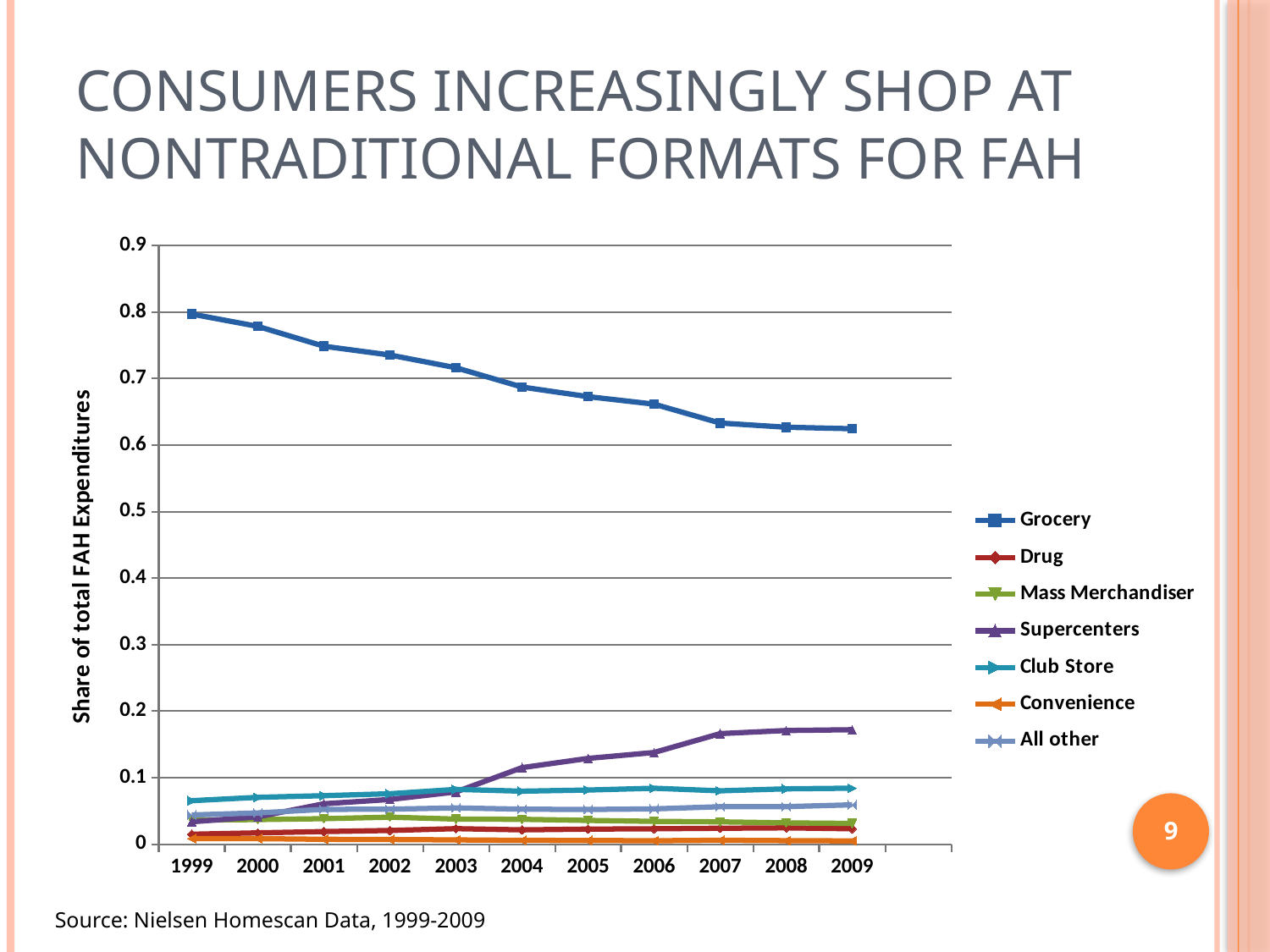
Which series has the highest share in 2009? Grocery Does the Grocery share rise or fall from 1999 to 2009? Fall Which series has the lowest share in 2009? Convenience What kind of chart is shown on the slide? Line chart How many years are plotted along the x axis? 11 Is the Supercenters value for 2009 greater or less than 0.2? less Is the Grocery value for 2009 greater or less than 0.7? less In 2009, which is larger: the Supercenters share or the Club Store share? Supercenters How many series does the legend list? 7 What is the label of the y axis? Share of total FAH Expenditures Does the Supercenters share rise or fall from 1999 to 2009? Rise Is the Grocery value for 1999 greater or less than 0.7? greater